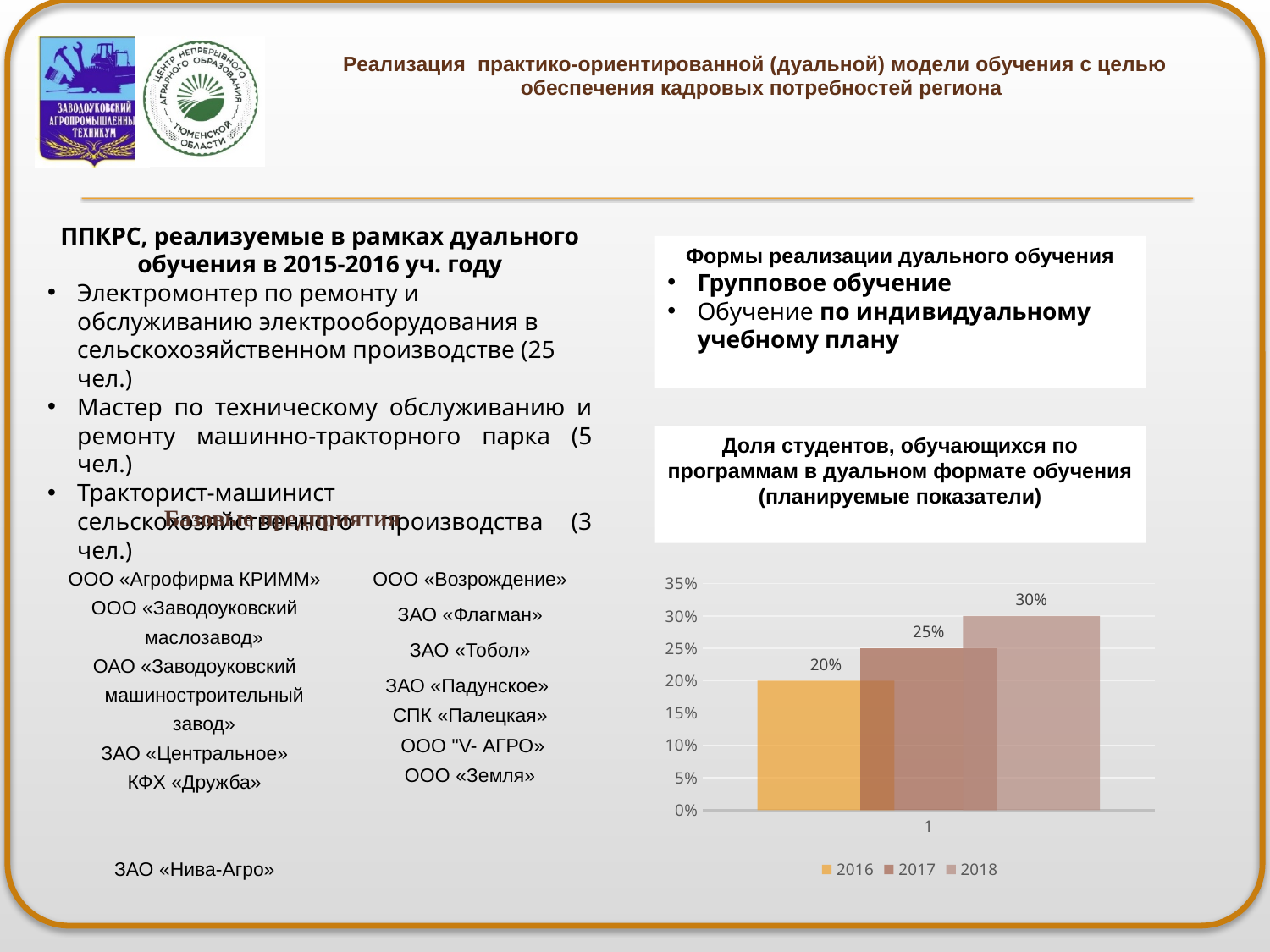
What is the value for the 2017 series in the chart? 25% How many series does the chart legend list? 3 What is the difference between the 2018 and 2016 values in the chart? 10% Which series has the highest value in the chart? 2018 What kind of chart is shown on the slide? Bar chart What is the highest value shown on the chart's vertical axis? 35% Do the values rise or fall from the 2016 series to the 2018 series? Rise What is the value for the 2018 series in the chart? 30% What is the value for the 2016 series in the chart? 20% Which series has the lowest value in the chart? 2016 Which is larger in the chart, the value for 2017 or the value for 2018? 2018 What is the difference between the 2017 and 2016 values in the chart? 5%